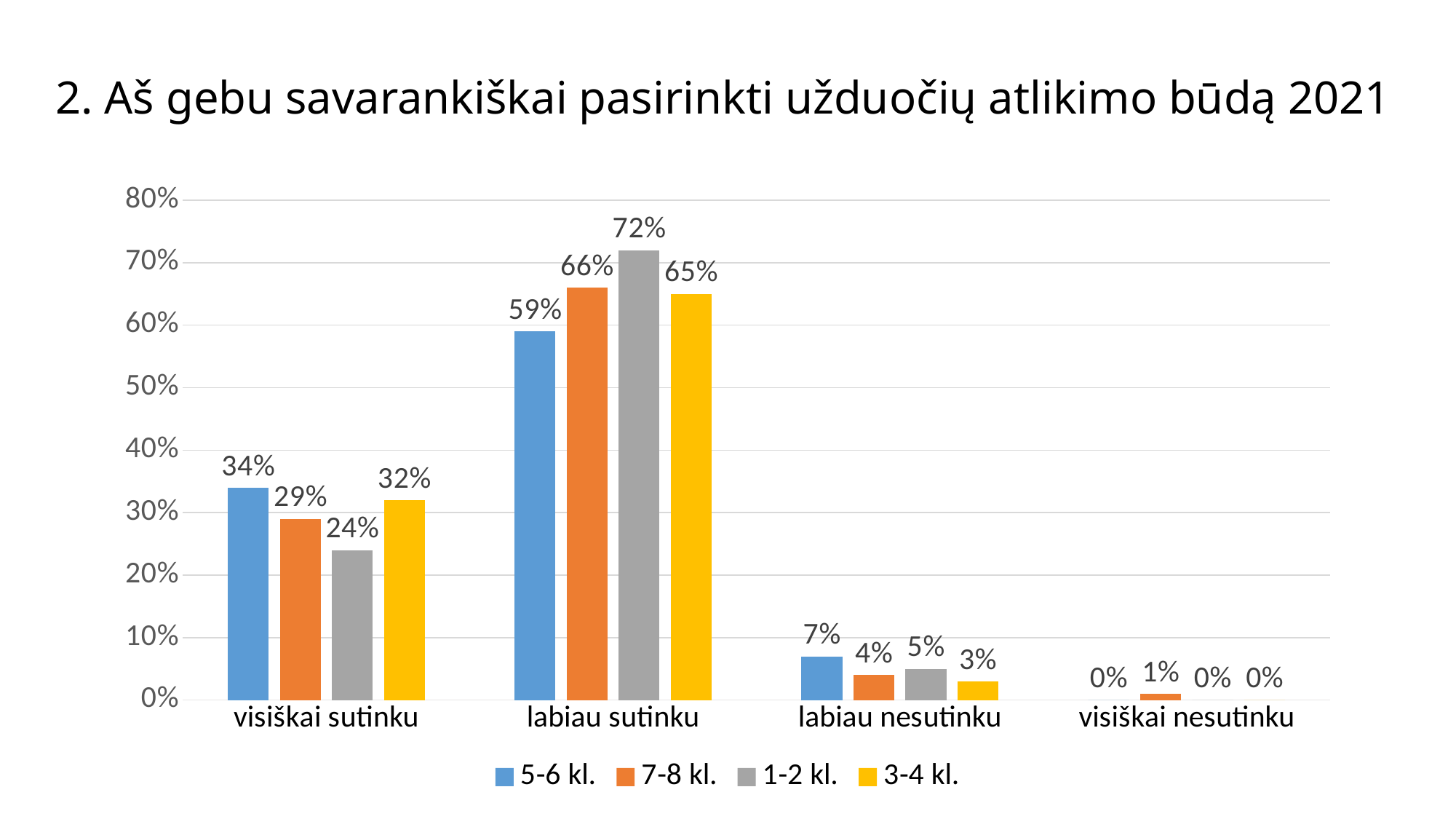
What is the value for 7-8 kl. in the 'visiškai nesutinku' category? 1% What is the title of the chart? 2. Aš gebu savarankiškai pasirinkti užduočių atlikimo būdą 2021 What is the value for 3-4 kl. in the 'labiau nesutinku' category? 3% How many categories are shown on the x axis? 4 Which series has the lowest value in the 'visiškai sutinku' category? 1-2 kl. What is the value for 1-2 kl. in the 'labiau sutinku' category? 72% How many series does the legend list? 4 What kind of chart is shown on the slide? bar chart What is the value for 5-6 kl. in the 'visiškai sutinku' category? 34% Which series has the highest value in the 'labiau sutinku' category? 1-2 kl. What is the difference between the 1-2 kl. and 5-6 kl. values in the 'labiau sutinku' category? 13% In the 'visiškai sutinku' category, which is larger: the value for 5-6 kl. or the value for 3-4 kl.? 5-6 kl.